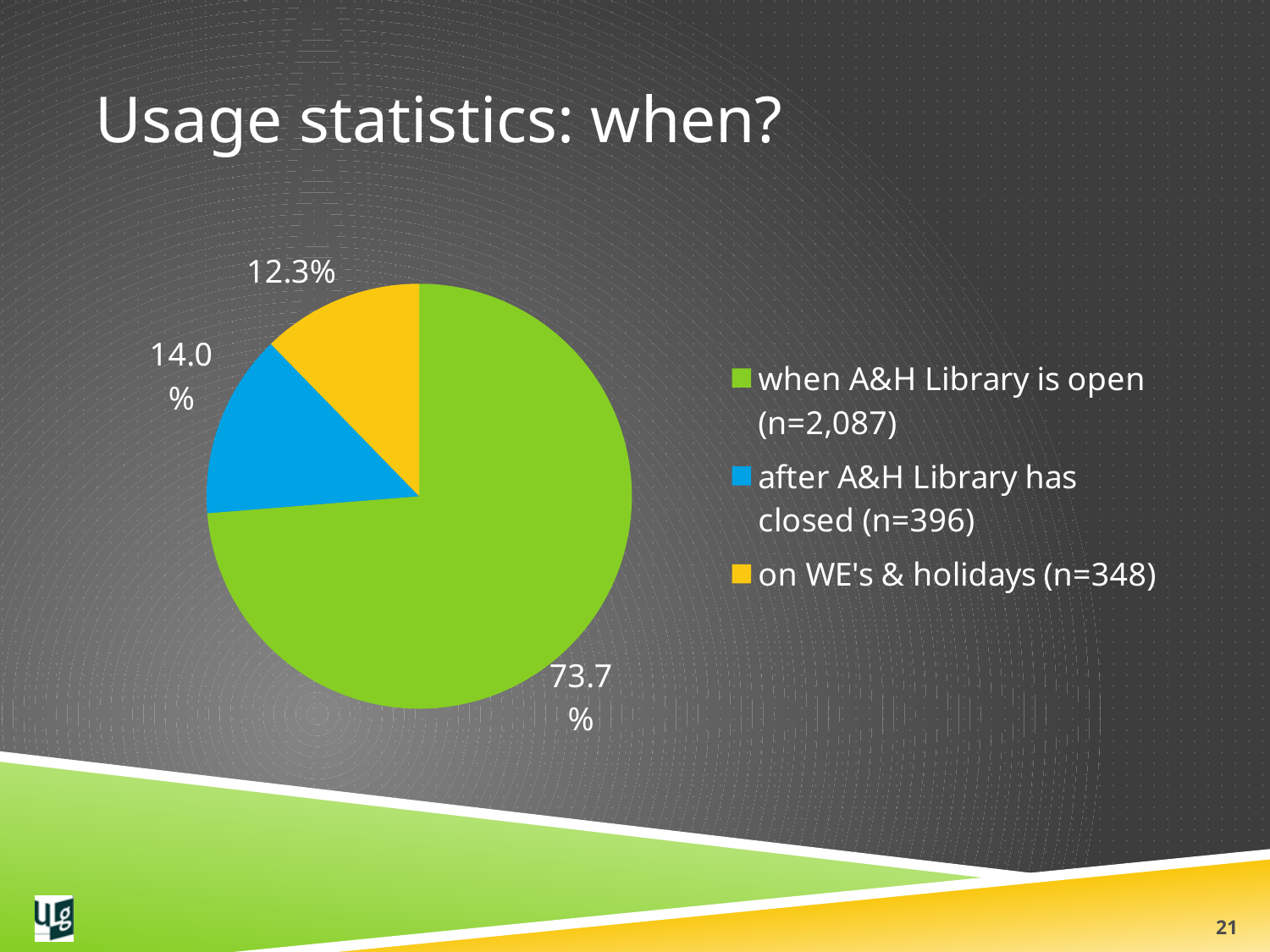
What is the difference in percentage points between the after-closing share and the WE's & holidays share? 1.7 What colour represents usage on WE's & holidays? yellow What percentage of usage occurs on WE's & holidays? 12.3% According to the legend, what is the n value for usage when A&H Library is open? 2,087 How many categories does the pie chart show? 3 Which is larger: the share for after A&H Library has closed or the share for on WE's & holidays? after A&H Library has closed What percentage of usage occurs after A&H Library has closed? 14.0% Which category has the largest share of the pie? when A&H Library is open What type of chart is shown on the slide? pie chart What is the difference in percentage points between usage when the library is open and usage after it has closed? 59.7 Which category has the smallest share of the pie? on WE's & holidays What percentage of usage occurs when A&H Library is open? 73.7%